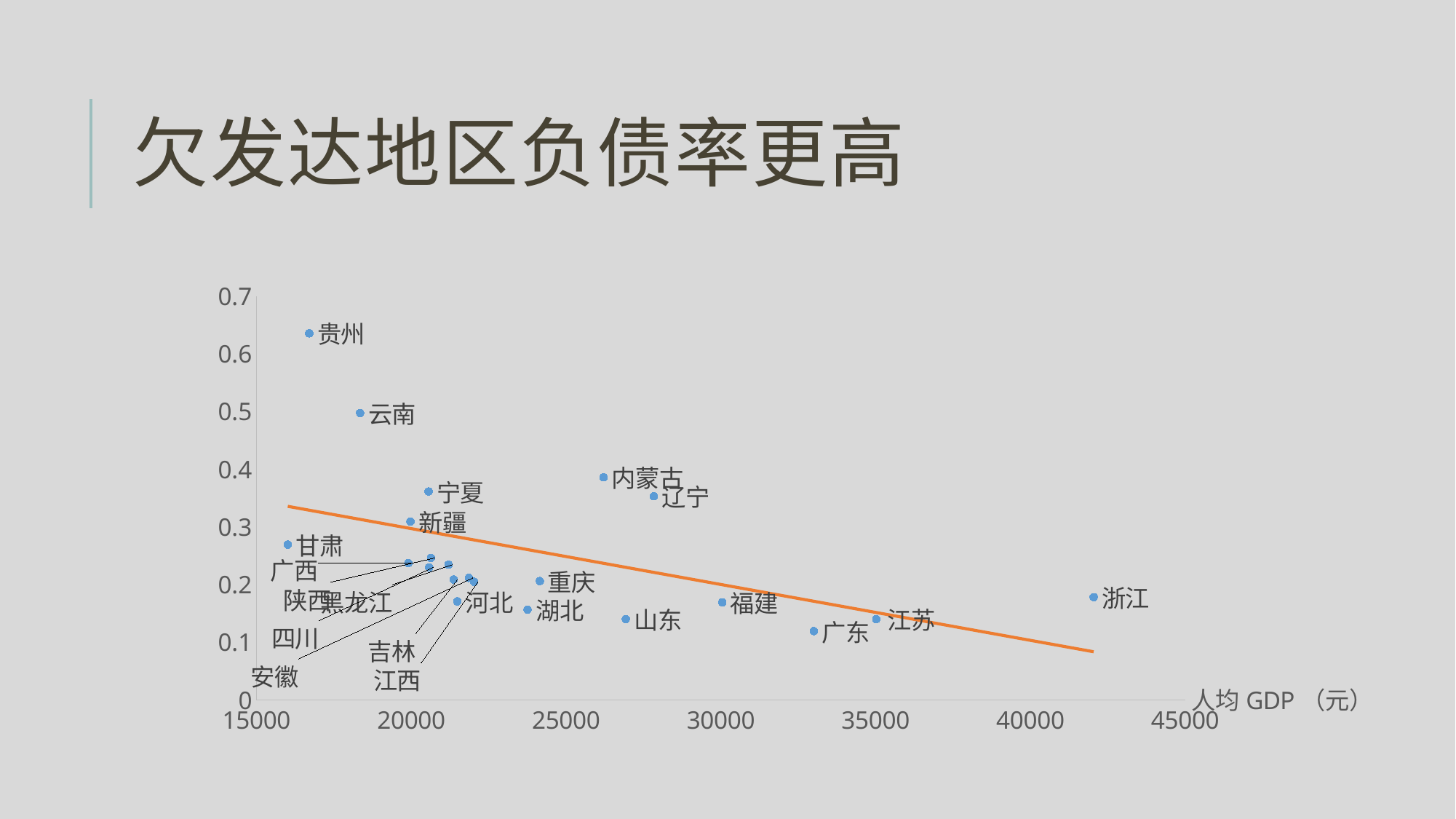
Is the vertical-axis value for 广东 greater or less than 0.2? less Is the vertical-axis value for 宁夏 greater or less than 0.3? greater What is the title of the slide? 欠发达地区负债率更高 Is the 人均 GDP for 浙江 greater or less than 40000? greater Which province has the highest 人均 GDP (furthest right on the x axis)? 浙江 What is the label of the horizontal axis? 人均 GDP（元） Which province has the highest value on the vertical axis? 贵州 Which province has the lowest 人均 GDP (furthest left on the x axis)? 甘肃 Which has the higher vertical-axis value, 贵州 or 云南? 贵州 What kind of chart is shown on the slide? scatter chart Does the trend line rise or fall as 人均 GDP increases? fall